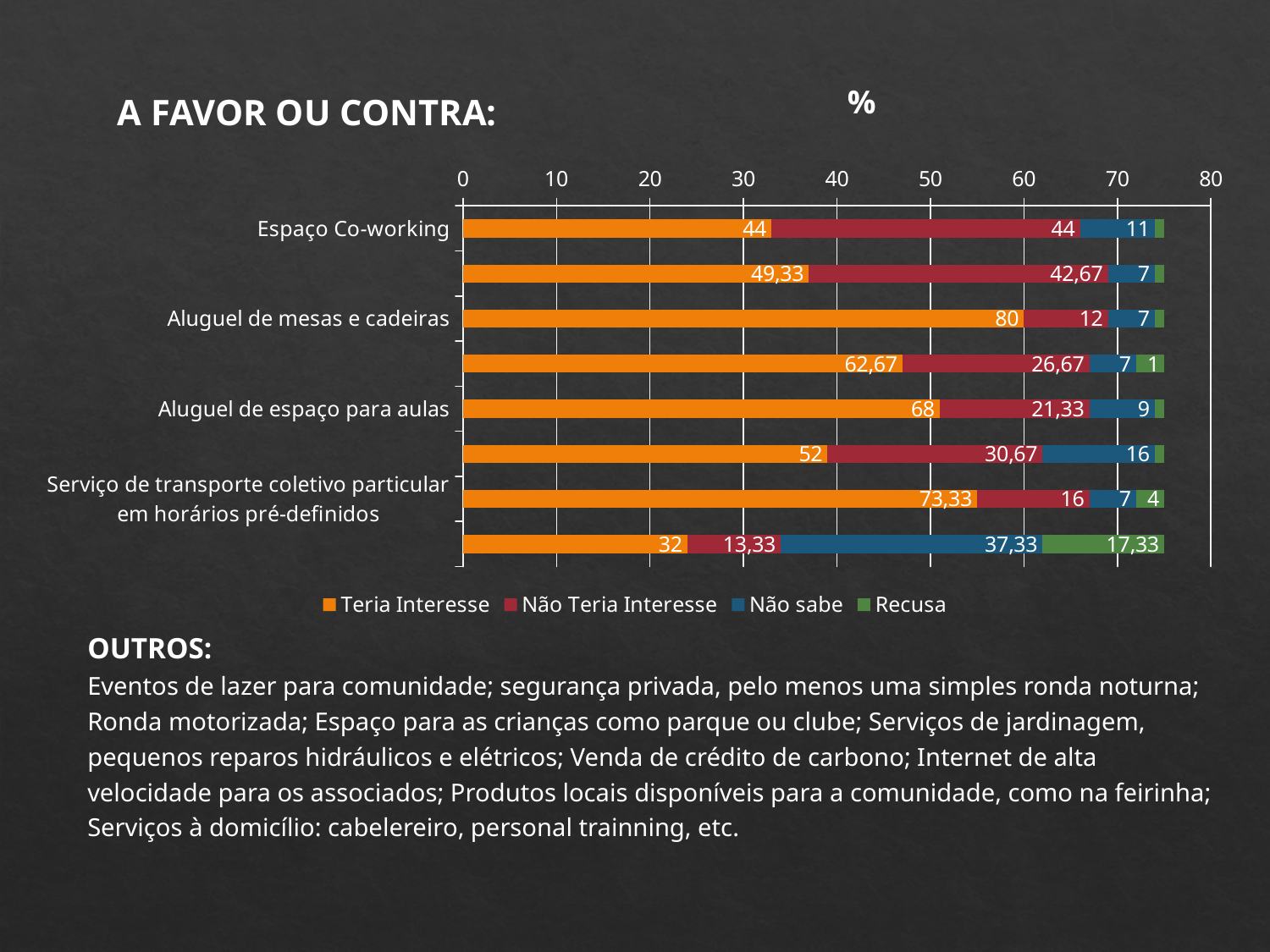
Which has the larger 'Teria Interesse' value: 'Aluguel de espaço para aulas' or 'Serviço de transporte coletivo particular em horários pré-definidos'? Serviço de transporte coletivo particular em horários pré-definidos Which category has the highest 'Teria Interesse' value? Aluguel de mesas e cadeiras What is the 'Não Teria Interesse' value for 'Aluguel de espaço para aulas'? 21,33 What is the 'Teria Interesse' value for 'Serviço de transporte coletivo particular em horários pré-definidos'? 73,33 How many series does the legend list? 4 What kind of chart is shown on the slide? Stacked bar chart What is the 'Recusa' value for 'Serviço de transporte coletivo particular em horários pré-definidos'? 4 How many bars are plotted in the chart? 8 What is the 'Teria Interesse' value for 'Aluguel de mesas e cadeiras'? 80 What is the 'Não Teria Interesse' value for 'Espaço Co-working'? 44 For 'Aluguel de mesas e cadeiras', what is the difference between the 'Teria Interesse' and 'Não Teria Interesse' values? 68 What is the 'Não sabe' value for 'Aluguel de espaço para aulas'? 9